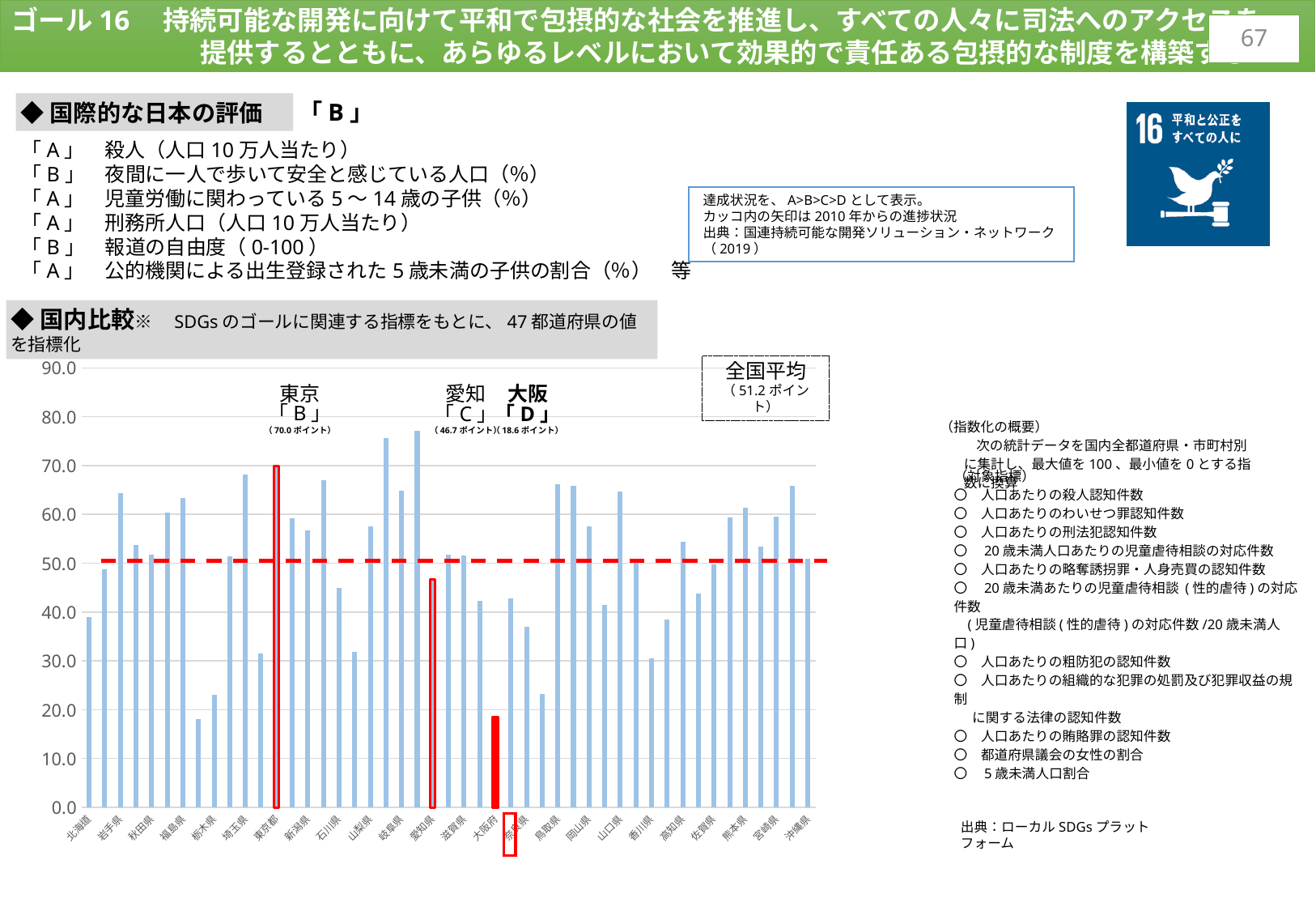
What is the difference between the values for 愛知 and 大阪? 28.1 ポイント What is the value shown for 東京 in the bar chart? 70.0 ポイント What is the value shown for 大阪 in the bar chart? 18.6 ポイント Which has the larger value, 東京 or 愛知? 東京 Is the value for 岡山県 greater or less than 60.0? less What is the value shown for 愛知 in the bar chart? 46.7 ポイント What grade is shown for 大阪 above the bar chart? 「D」 What is the difference between the values for 東京 and 大阪? 51.4 ポイント What is the 全国平均 value indicated on the chart? 51.2 ポイント Is the value for 栃木県 greater or less than 30.0? less What kind of chart is used for the 国内比較 section? bar chart